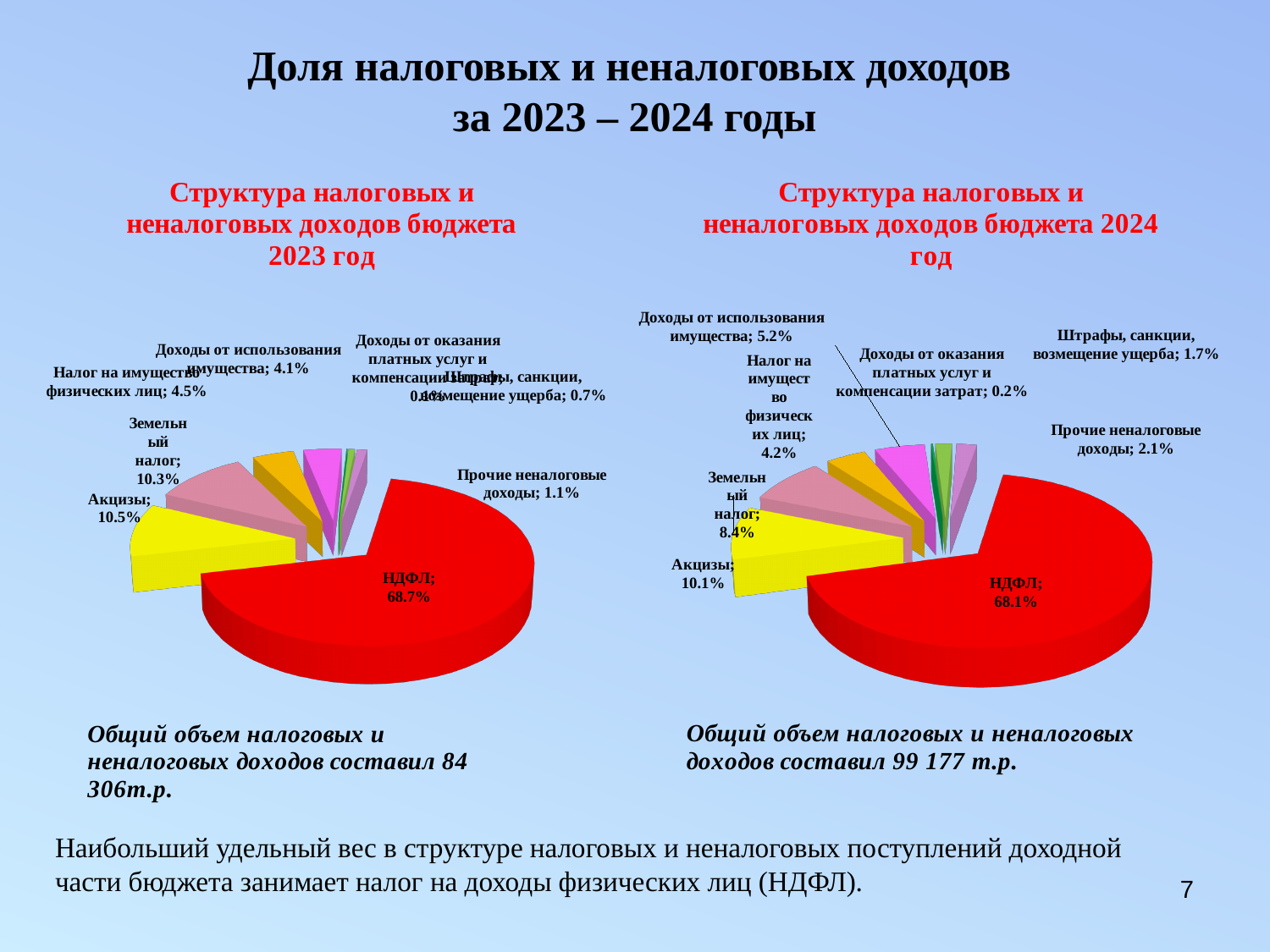
In the 2024 pie chart (right), which category has the smallest share? Доходы от оказания платных услуг и компенсации затрат In the 2024 pie chart (right), what is the share of Штрафы, санкции, возмещение ущерба? 1.7% What type of chart is used on the left for the 2023 structure? Pie chart In the 2023 pie chart (left), what is the share of Акцизы? 10.5% In the 2023 pie chart (left), what is the difference between the shares of Акцизы and Земельный налог? 0.2% In the 2024 pie chart (right), which is larger: Акцизы or Земельный налог? Акцизы In the 2023 pie chart (left), which category has the largest share? НДФЛ How many categories are shown in the 2024 pie chart (right)? 8 In the 2024 pie chart (right), what is the share of Земельный налог? 8.4% In the 2024 pie chart (right), what is the share of Доходы от использования имущества? 5.2% In the 2023 pie chart (left), what share does НДФЛ have? 68.7% In the 2024 pie chart (right), what share does НДФЛ have? 68.1%